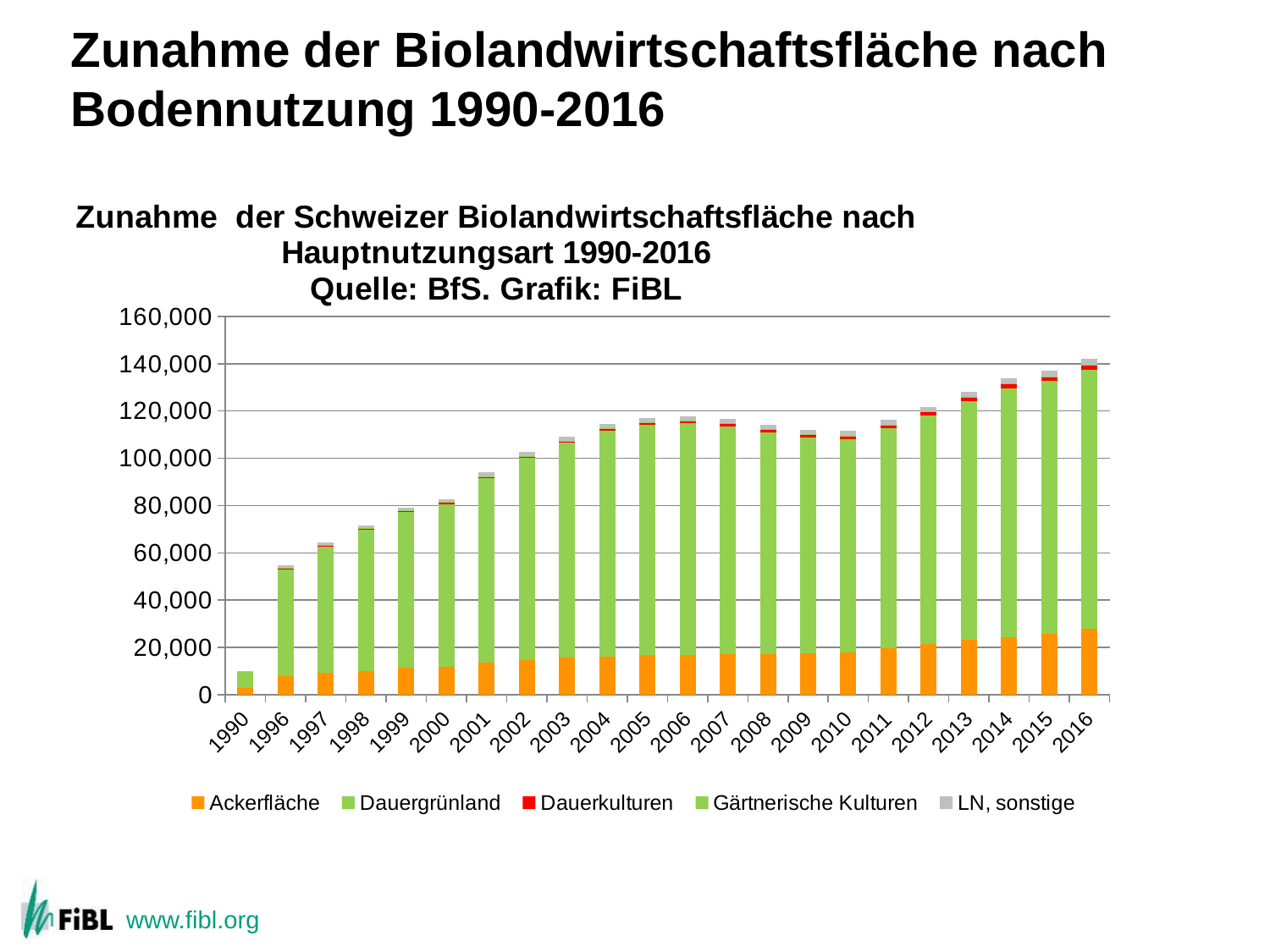
Which year has the highest total bar? 2016 Is the total value for 1996 greater or less than 60,000? less Do the total values generally rise or fall from 1990 to 2016? rise What kind of chart is shown on the slide? bar chart Is the total value for 1990 greater or less than 20,000? less How many years are shown on the x axis? 22 Which series is listed first in the legend? Ackerfläche Is the Ackerfläche value for 2016 greater or less than 20,000? greater Which year has the larger total bar, 2001 or 2005? 2005 Which year has the lowest total bar? 1990 How many series does the legend list? 5